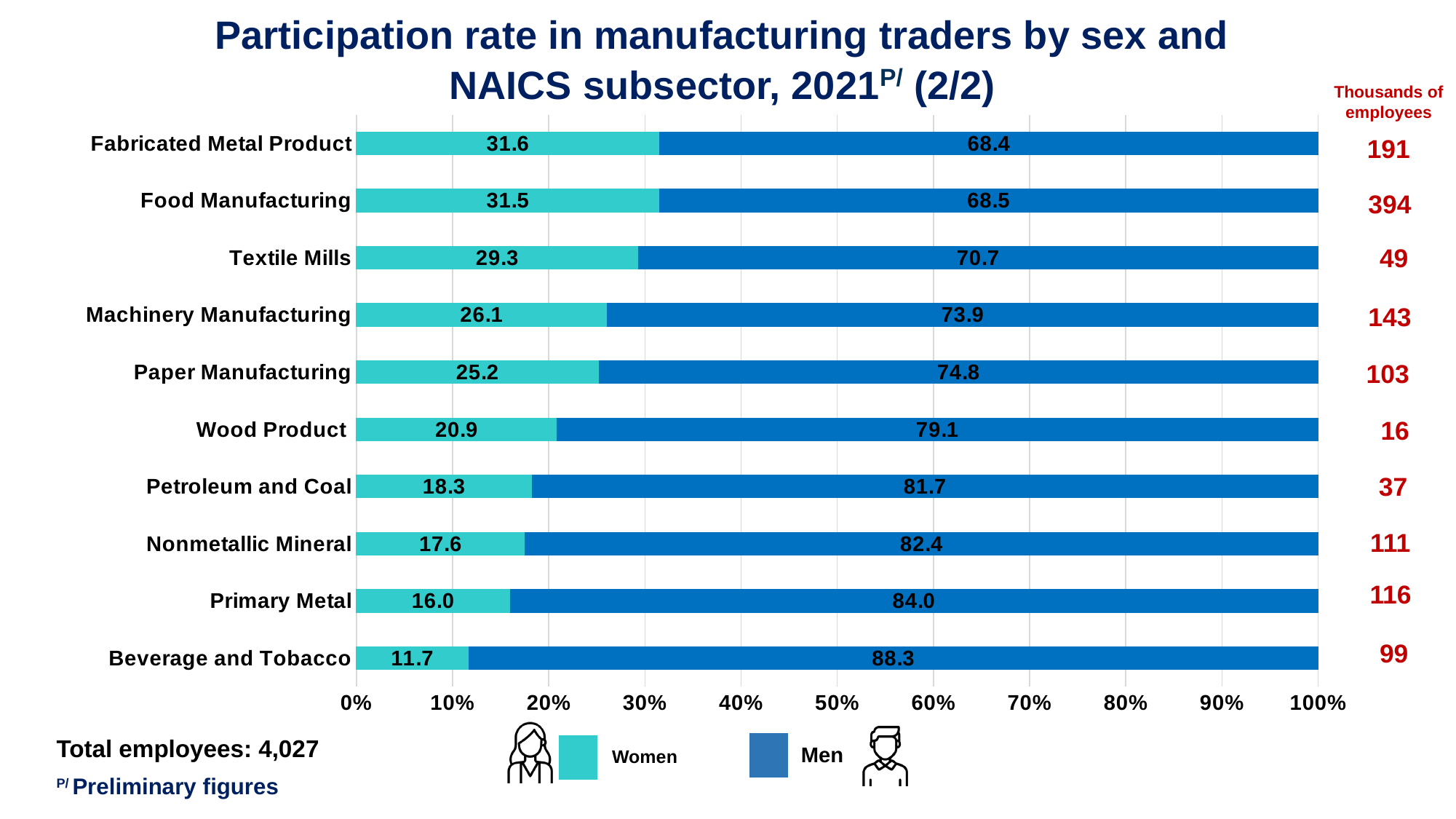
Which subsector has the highest Women value? Fabricated Metal Product Which is larger, the Women value for Machinery Manufacturing or the Women value for Wood Product? Machinery Manufacturing How many subsectors are shown on the chart? 10 What is the Men value for Petroleum and Coal? 81.7 Which subsector has the lowest Women value? Beverage and Tobacco What is the Women value for Textile Mills? 29.3 What is the difference between the Men value for Beverage and Tobacco and the Men value for Fabricated Metal Product? 19.9 How many series does the legend list? 2 What is the total of the stacked bar for Primary Metal? 100.0 How many thousands of employees are listed for Food Manufacturing? 394 What kind of chart is shown on the slide? Stacked bar chart Which colour represents Women in the chart? Turquoise